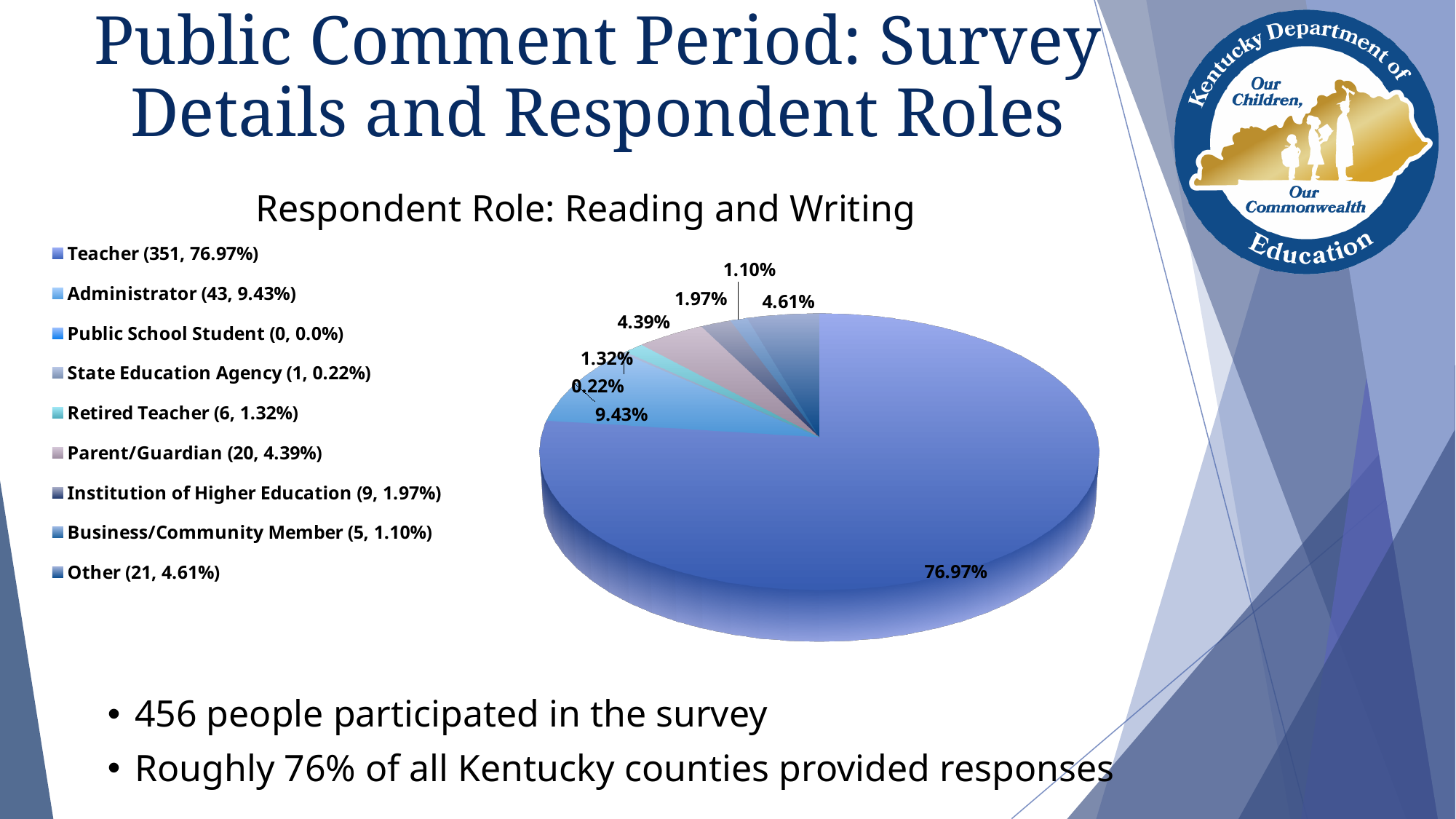
How many respondents were Administrators? 43 How many respondents were from an Institution of Higher Education? 9 Which has more respondents, Administrator or Parent/Guardian? Administrator What is the difference in percentage points between Other and Parent/Guardian? 0.22% What kind of chart is shown on the slide? pie chart How many more respondents were Teachers than Administrators? 308 How many respondent role categories does the legend list? 9 What percentage of respondents were Teachers? 76.97% Which respondent role has the largest share of the pie? Teacher What is the title of the chart? Respondent Role: Reading and Writing What share of the pie is Retired Teacher? 1.32% Which respondent role has the smallest share of the pie? Public School Student